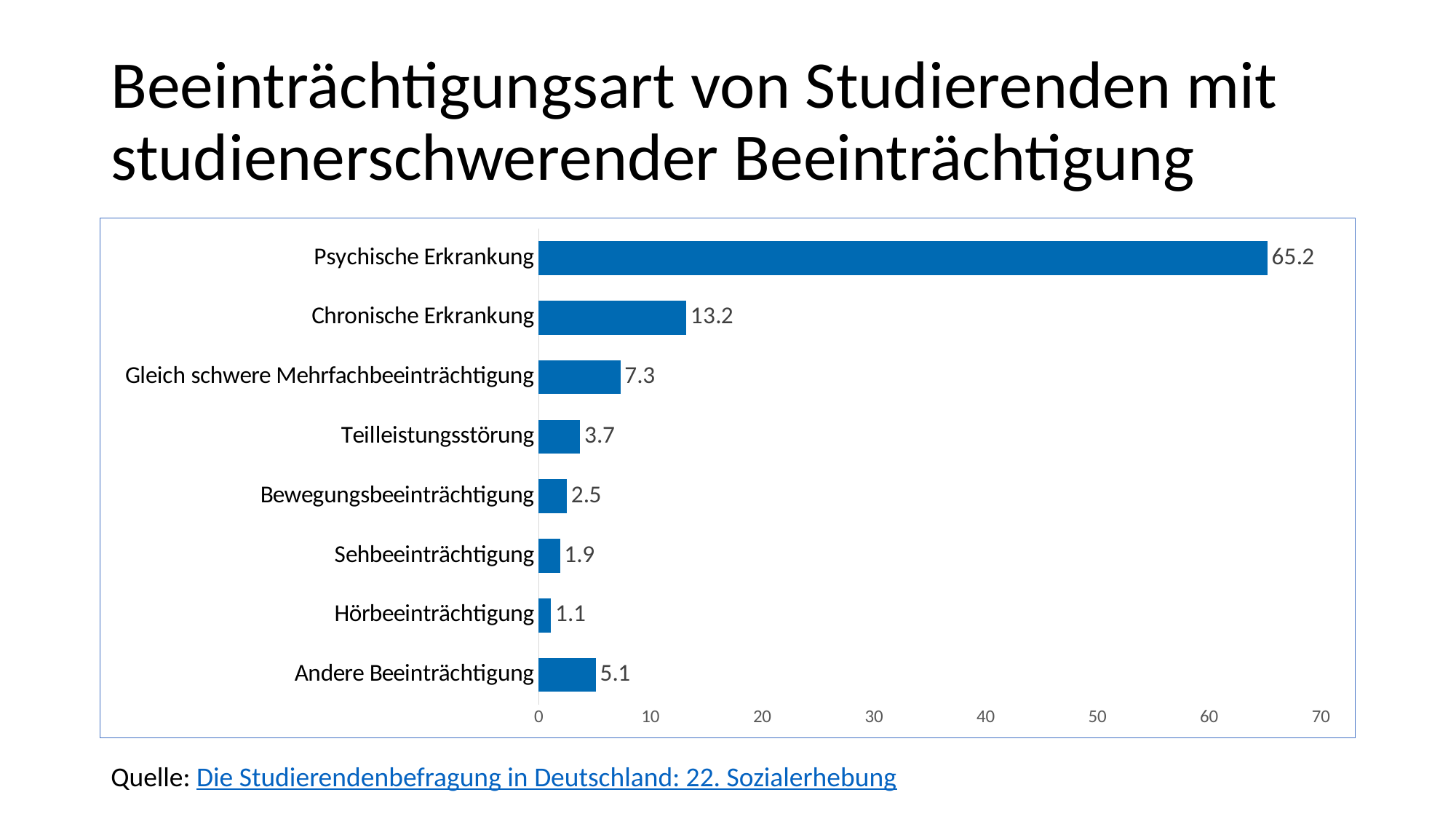
Which is larger, the value for Gleich schwere Mehrfachbeeinträchtigung or the value for Andere Beeinträchtigung? Gleich schwere Mehrfachbeeinträchtigung What is the difference between the values for Psychische Erkrankung and Chronische Erkrankung? 52.0 What is the difference between the values for Bewegungsbeeinträchtigung and Sehbeeinträchtigung? 0.6 Is the value for Chronische Erkrankung greater or less than 10? greater How many categories are shown in the chart? 8 What is the value for Teilleistungsstörung? 3.7 What is the value for Psychische Erkrankung? 65.2 Which category has the lowest value? Hörbeeinträchtigung What is the value for Andere Beeinträchtigung? 5.1 What kind of chart is shown on the slide? Bar chart What is the value for Chronische Erkrankung? 13.2 Which category has the highest value? Psychische Erkrankung